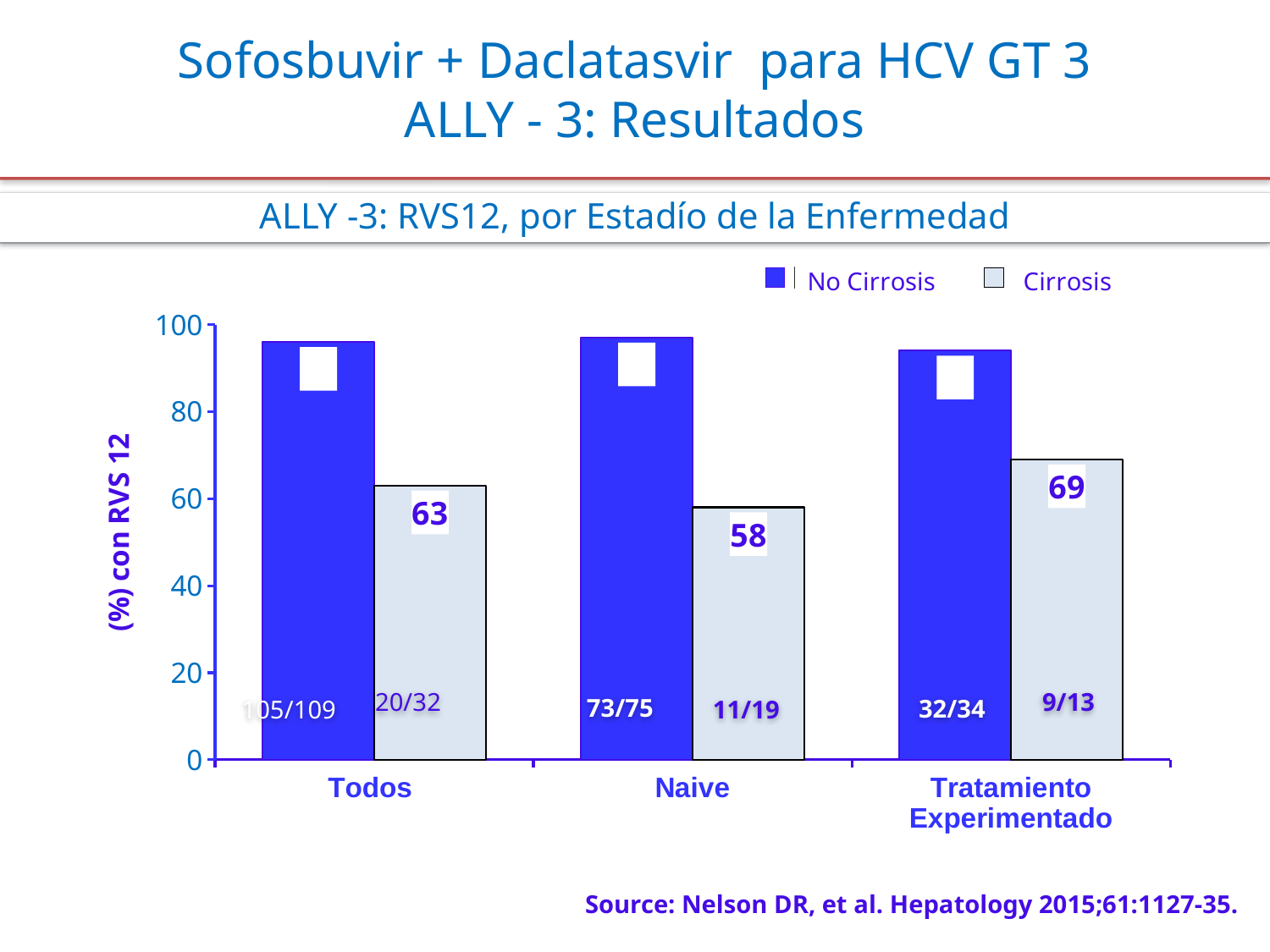
What fraction is printed on the No Cirrosis bar for the Naive category? 73/75 What is the difference between the Cirrosis values for Tratamiento Experimentado and Naive? 11 Which category has the highest Cirrosis value? Tratamiento Experimentado What is the value for Cirrosis in the Tratamiento Experimentado category? 69 Which category has the lowest Cirrosis value? Naive How many categories are shown on the x axis? 3 Which is larger, the Cirrosis value for Todos or for Naive? Todos How many series does the legend list? 2 What is the value for Cirrosis in the Naive category? 58 What kind of chart is shown on the slide? bar chart What is the value for Cirrosis in the Todos category? 63 Is the value for No Cirrosis in the Todos category greater or less than 80? greater